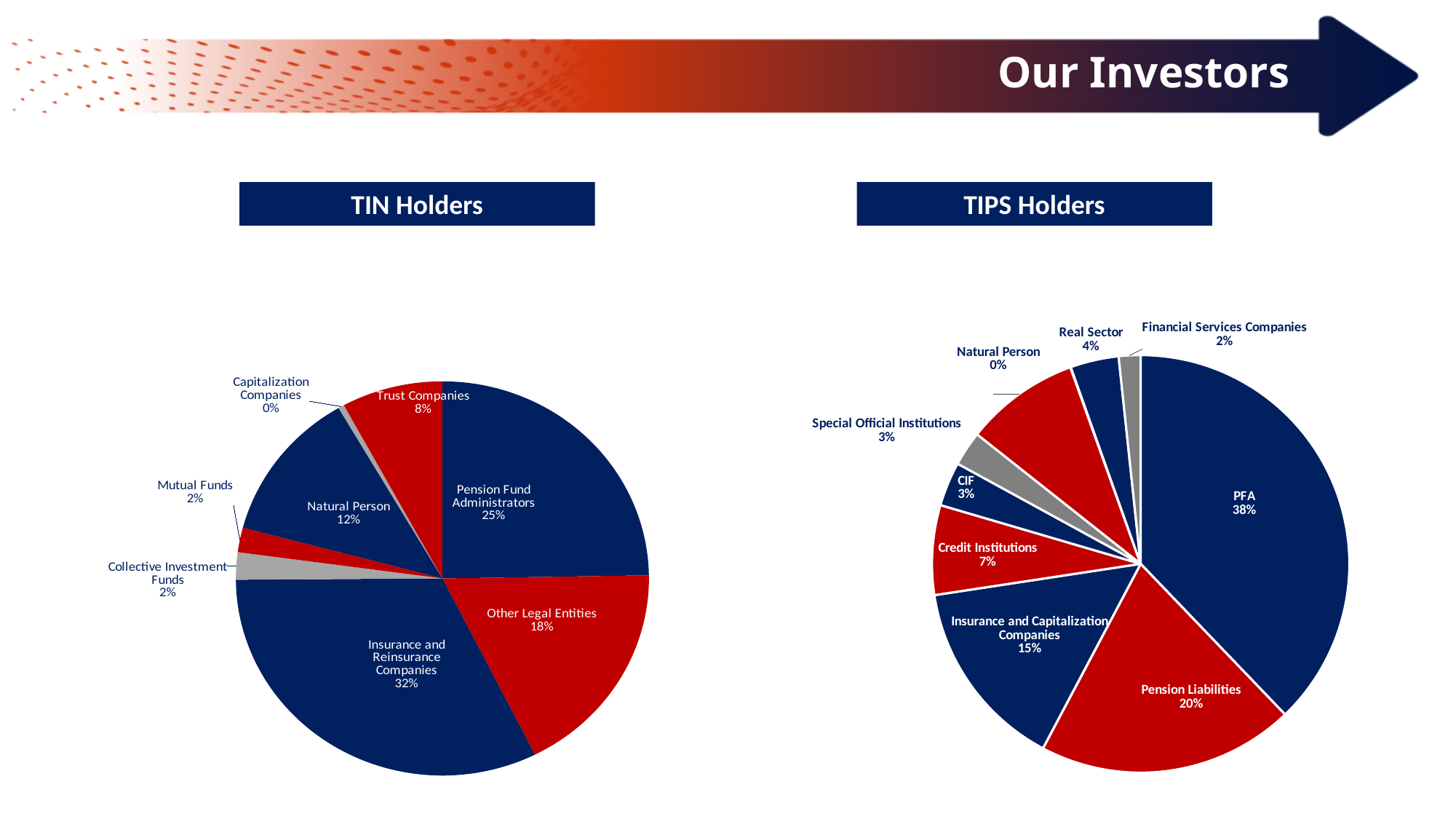
In the TIPS Holders chart, what is the difference between PFA and Pension Liabilities? 18% What type of chart is used for the TIPS Holders? Pie chart How many categories are shown in the TIPS Holders chart? 10 In the TIN Holders chart, what is the difference between Other Legal Entities and Natural Person? 6% In the TIN Holders chart, what is the value for Pension Fund Administrators? 25% In the TIN Holders chart, what share do Insurance and Reinsurance Companies hold? 32% In the TIPS Holders chart, what share does PFA hold? 38% How many categories are shown in the TIN Holders chart? 8 In the TIN Holders chart, which category has the largest share? Insurance and Reinsurance Companies In the TIPS Holders chart, which is larger: Pension Liabilities or Insurance and Capitalization Companies? Pension Liabilities In the TIN Holders chart, which category has the smallest share? Capitalization Companies In the TIPS Holders chart, what is the value for Credit Institutions? 7%